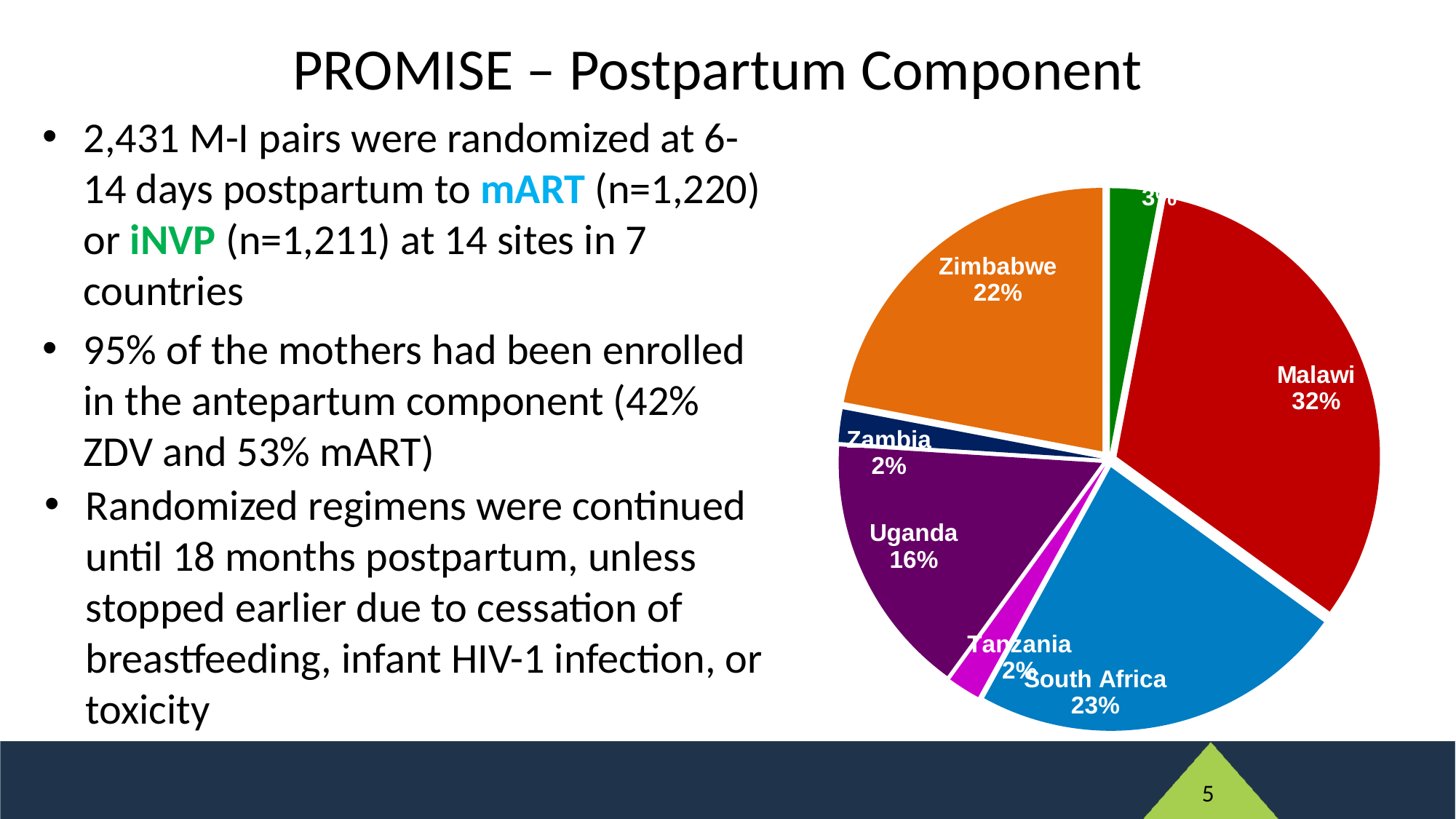
What colour is the Malawi slice? red What is the difference in percentage points between Malawi and Uganda? 16 What is the difference in percentage points between South Africa and Zimbabwe? 1 What percentage is shown for South Africa? 23% How many slices does the pie chart have? 7 What percentage is shown for Uganda? 16% Which country has the largest slice of the pie? Malawi What percentage is shown for Zambia? 2% What share of the pie does Malawi account for? 32% What percentage is shown for Zimbabwe? 22% Which is larger, the slice for South Africa or the slice for Zimbabwe? South Africa What kind of chart is shown on the slide? pie chart